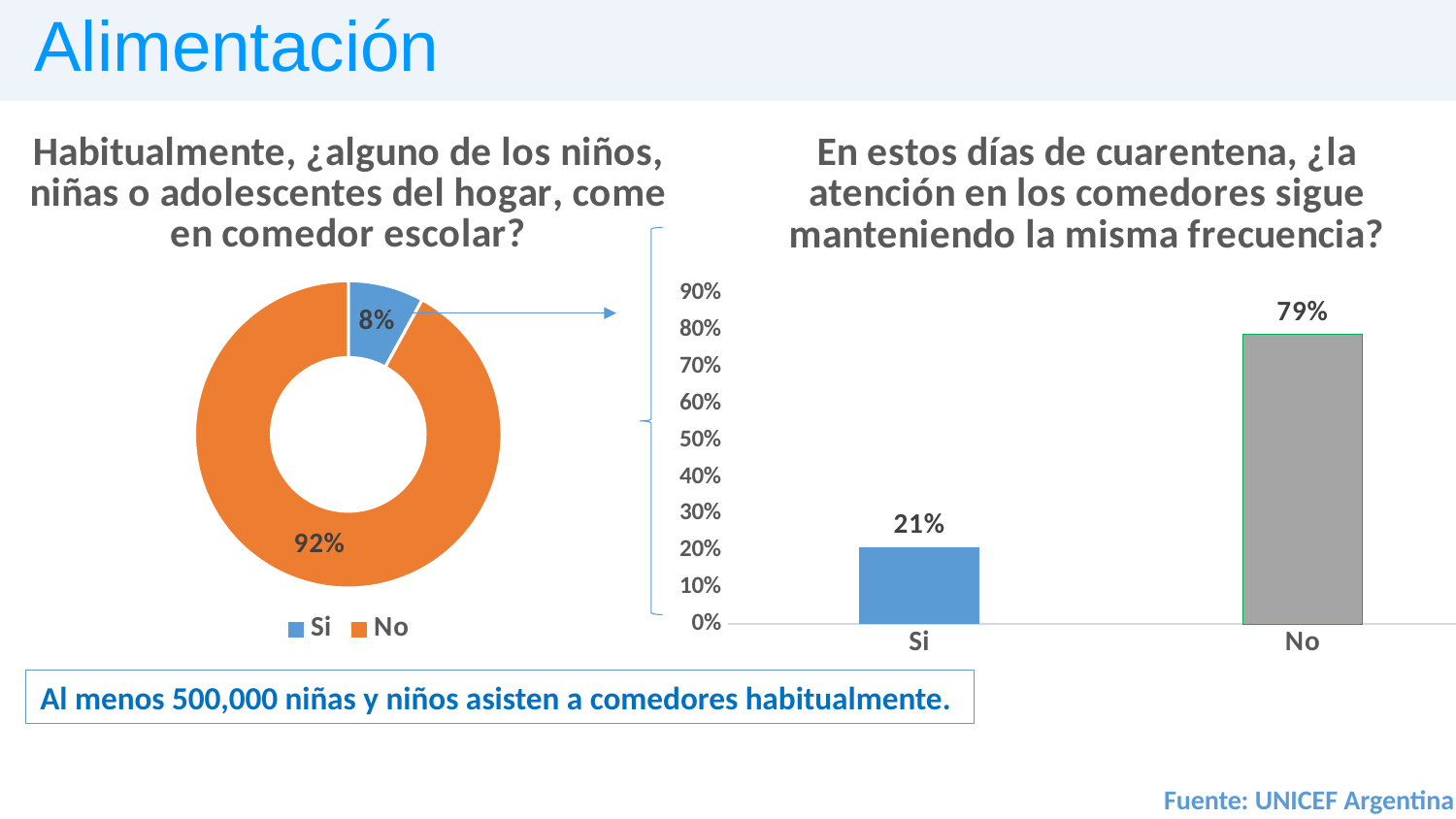
What kind of chart is the left chart (Habitualmente, ¿alguno de los niños, niñas o adolescentes del hogar, come en comedor escolar?)? Doughnut (pie) chart In the left chart (Habitualmente, ¿alguno de los niños, niñas o adolescentes del hogar, come en comedor escolar?), which category has the largest share? No In the right chart (En estos días de cuarentena, ¿la atención en los comedores sigue manteniendo la misma frecuencia?), how many categories are shown on the x axis? 2 In the left chart (Habitualmente, ¿alguno de los niños, niñas o adolescentes del hogar, come en comedor escolar?), what percentage is shown for 'Si'? 8% In the left chart (Habitualmente, ¿alguno de los niños, niñas o adolescentes del hogar, come en comedor escolar?), what percentage is shown for 'No'? 92% In the left chart (Habitualmente, ¿alguno de los niños, niñas o adolescentes del hogar, come en comedor escolar?), what is the difference between the 'No' and 'Si' shares? 84 percentage points What kind of chart is the right chart (En estos días de cuarentena, ¿la atención en los comedores sigue manteniendo la misma frecuencia?)? Bar chart In the right chart (En estos días de cuarentena, ¿la atención en los comedores sigue manteniendo la misma frecuencia?), what is the value for 'Si'? 21% In the right chart (En estos días de cuarentena, ¿la atención en los comedores sigue manteniendo la misma frecuencia?), what is the value for 'No'? 79% How many entries does the legend of the left chart (Habitualmente, ¿alguno de los niños, niñas o adolescentes del hogar, come en comedor escolar?) list? 2 In the right chart (En estos días de cuarentena, ¿la atención en los comedores sigue manteniendo la misma frecuencia?), which category has the highest value? No In the right chart (En estos días de cuarentena, ¿la atención en los comedores sigue manteniendo la misma frecuencia?), what is the difference between 'No' and 'Si'? 58 percentage points